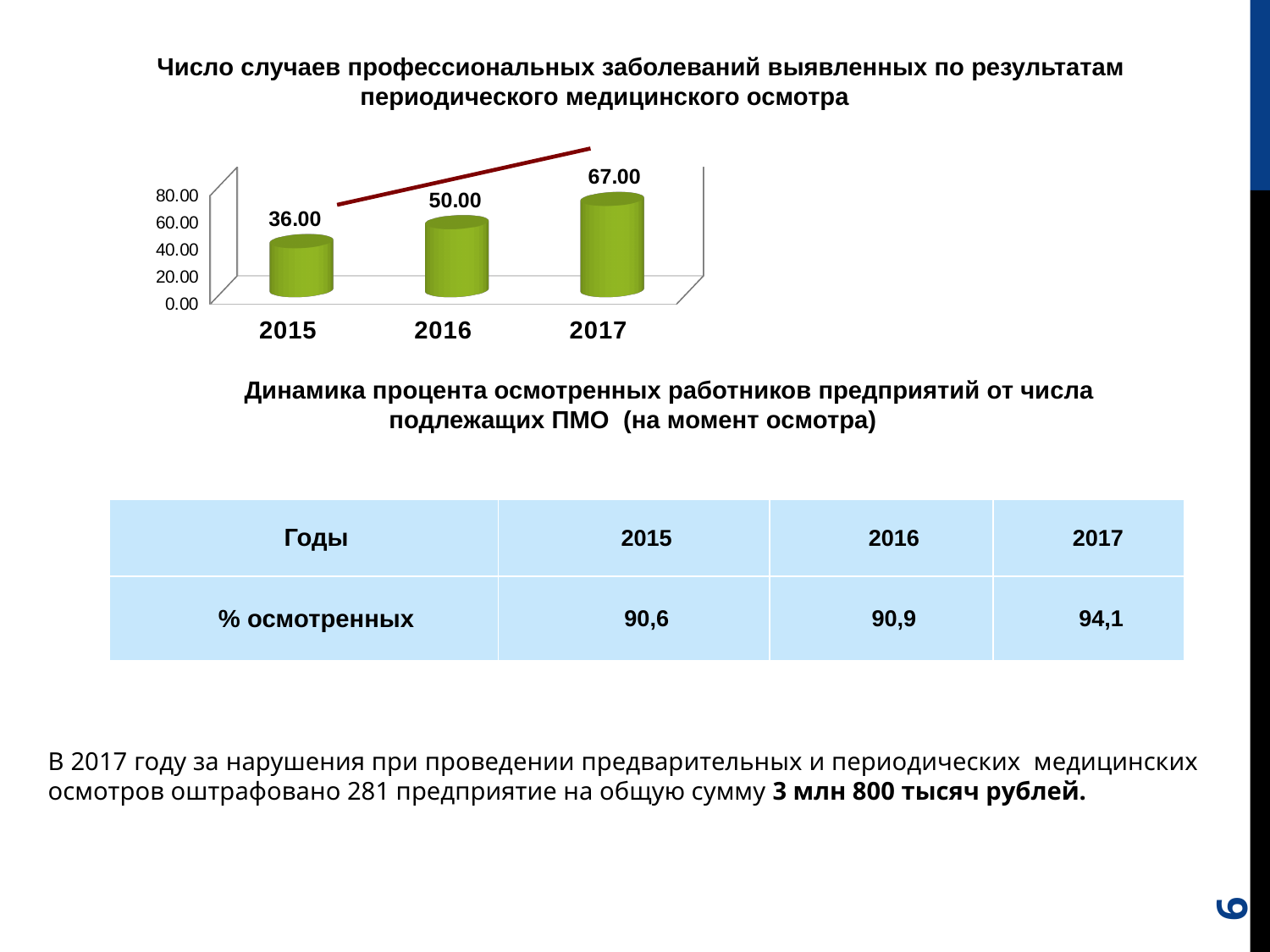
Which is larger in the chart of occupational disease cases, the value for 2016 or the value for 2017? 2017 Which year has the lowest value in the chart of occupational disease cases? 2015 How many years are shown on the x axis of the chart of occupational disease cases? 3 What is the difference between the 2017 and 2015 values in the chart of occupational disease cases? 31.00 Which year has the highest value in the chart of occupational disease cases? 2017 What is the difference between the 2016 and 2015 values in the chart of occupational disease cases? 14.00 What is the value for 2017 in the chart of occupational disease cases? 67.00 Do the values in the chart of occupational disease cases rise or fall from 2015 to 2017? rise What kind of chart is used to show the number of occupational disease cases? bar chart Is the value for 2017 in the chart of occupational disease cases greater or less than 60.00? greater What is the value for 2015 in the chart of occupational disease cases? 36.00 What is the value for 2016 in the chart of occupational disease cases? 50.00